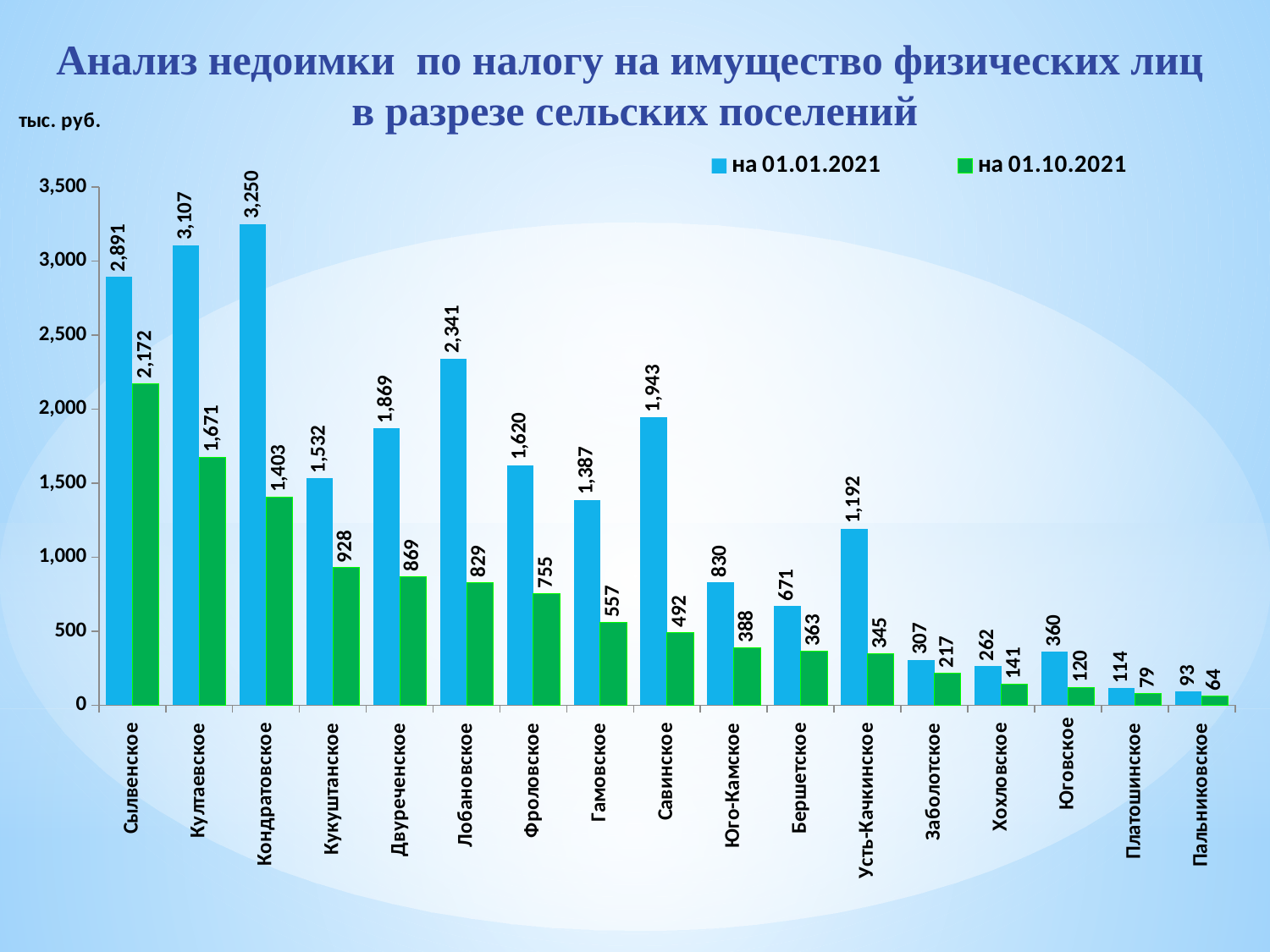
What is the value for Кондратовское in the series на 01.01.2021? 3,250 How many categories (settlements) are shown on the x axis? 17 Which is larger: the на 01.10.2021 value for Гамовское or for Савинское? Гамовское What is the value for Сылвенское in the series на 01.10.2021? 2,172 Which category has the lowest value in the series на 01.10.2021? Пальниковское What is the difference between the на 01.01.2021 values for Лобановское and Савинское? 398 Which category has the highest value in the series на 01.01.2021? Кондратовское What is the value for Усть-Качкинское in the series на 01.01.2021? 1,192 How many series does the legend list? 2 What kind of chart is shown on the slide? Bar chart What unit of measurement is indicated for the chart values? тыс. руб.